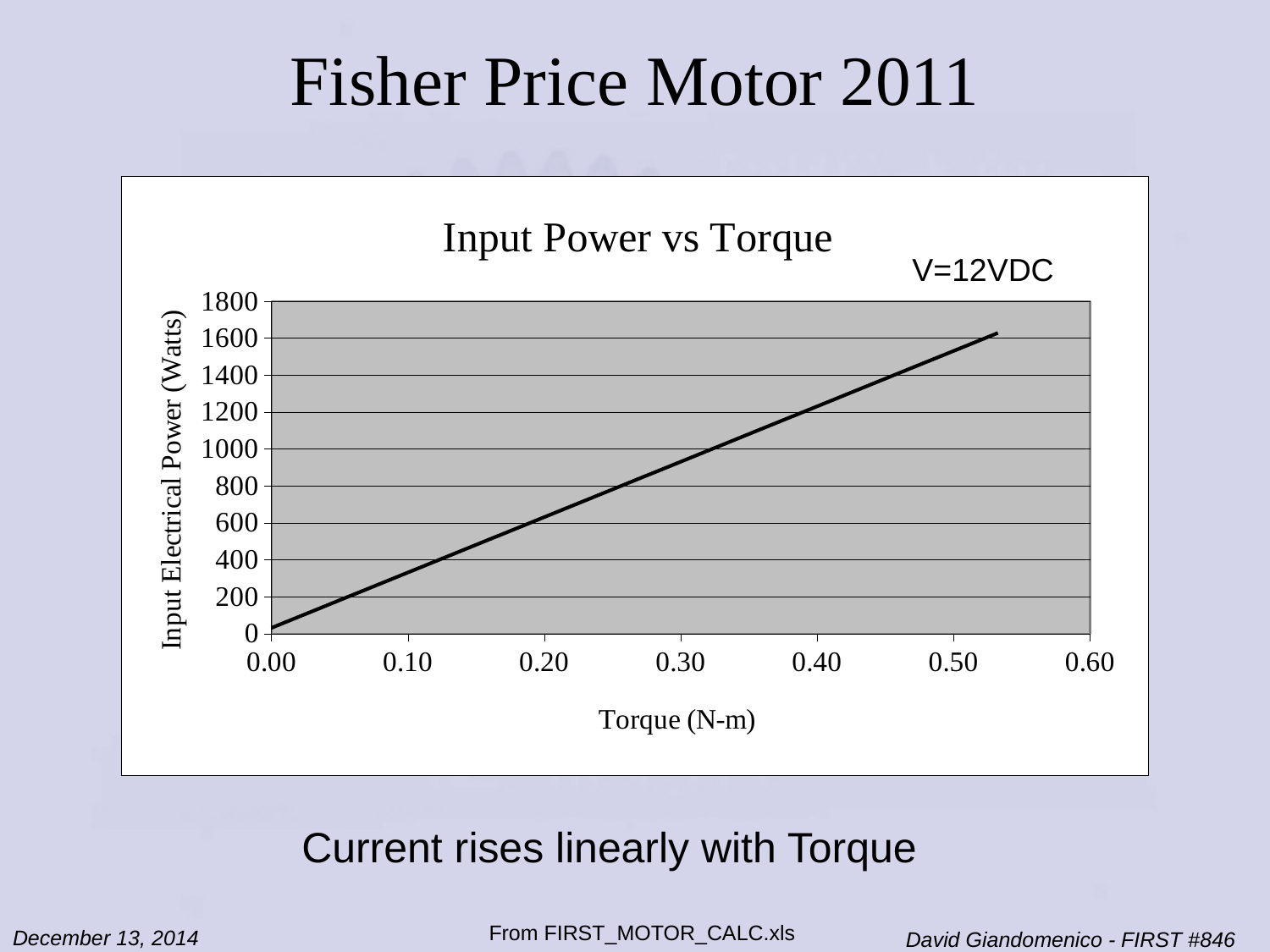
Is the input electrical power at a torque of 0.40 N-m greater or less than 1400 Watts? less What kind of chart is shown on the slide? line chart Is the input electrical power at a torque of 0.10 N-m greater or less than 400 Watts? less Is the input electrical power at a torque of 0.30 N-m greater or less than 1000 Watts? less Is the input electrical power higher at a torque of 0.40 N-m or at 0.20 N-m? 0.40 N-m What is the label of the y axis of the chart? Input Electrical Power (Watts) What is the title of the chart? Input Power vs Torque Does the input electrical power rise or fall as torque increases along the x axis? rises